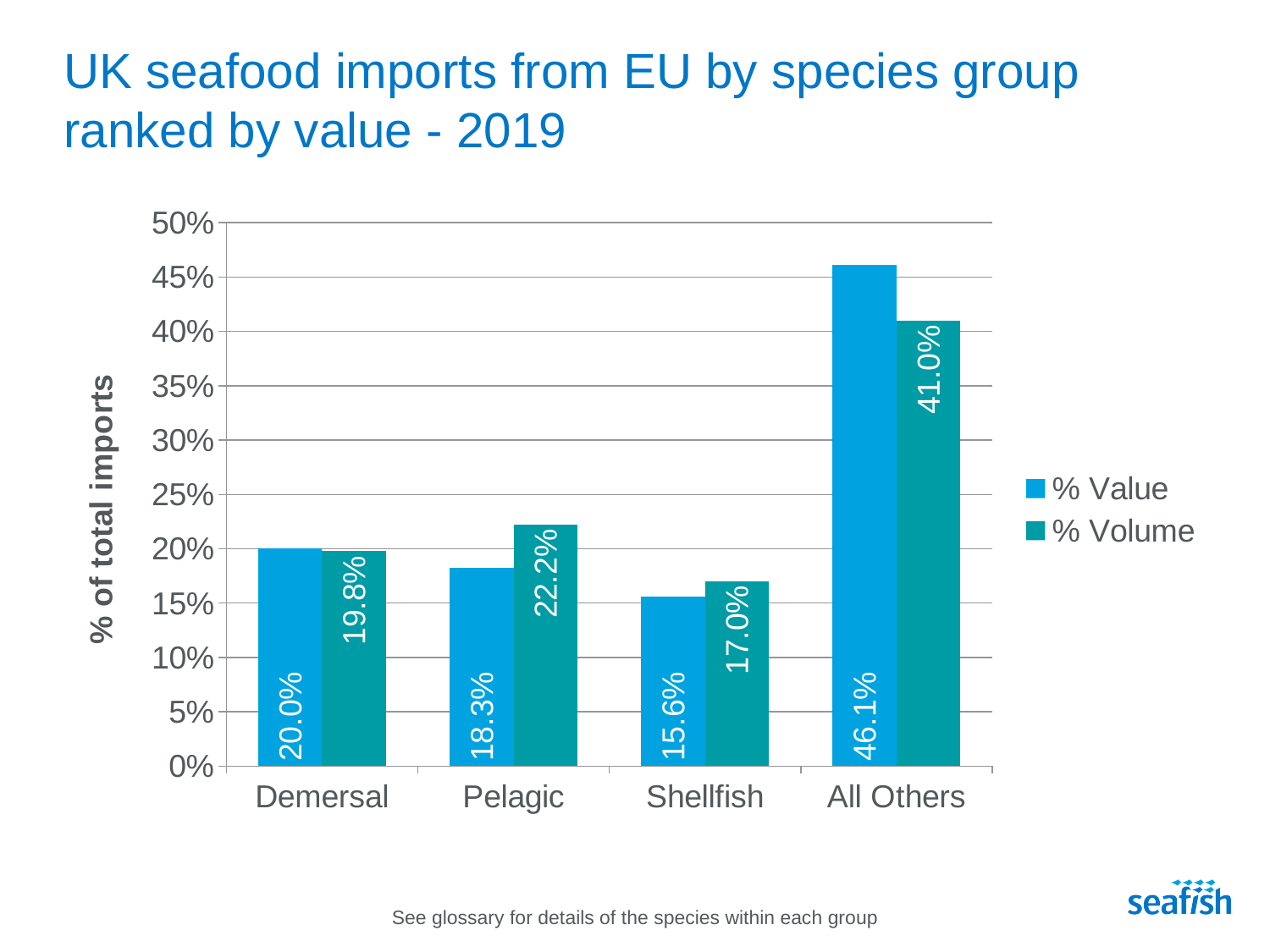
What is the % Value for All Others? 46.1% How many series does the legend list? 2 What kind of chart is shown on the slide? Bar chart What is the difference between the % Value and % Volume for All Others? 5.1% Which is larger for Pelagic, % Value or % Volume? % Volume What is the % Volume for Pelagic? 22.2% Which species group has the lowest % Volume? Shellfish What is the label of the y axis? % of total imports What is the % Value for Demersal? 20.0% Which species group has the highest % Value? All Others What is the % Volume for Shellfish? 17.0% How many species groups are shown on the x axis? 4